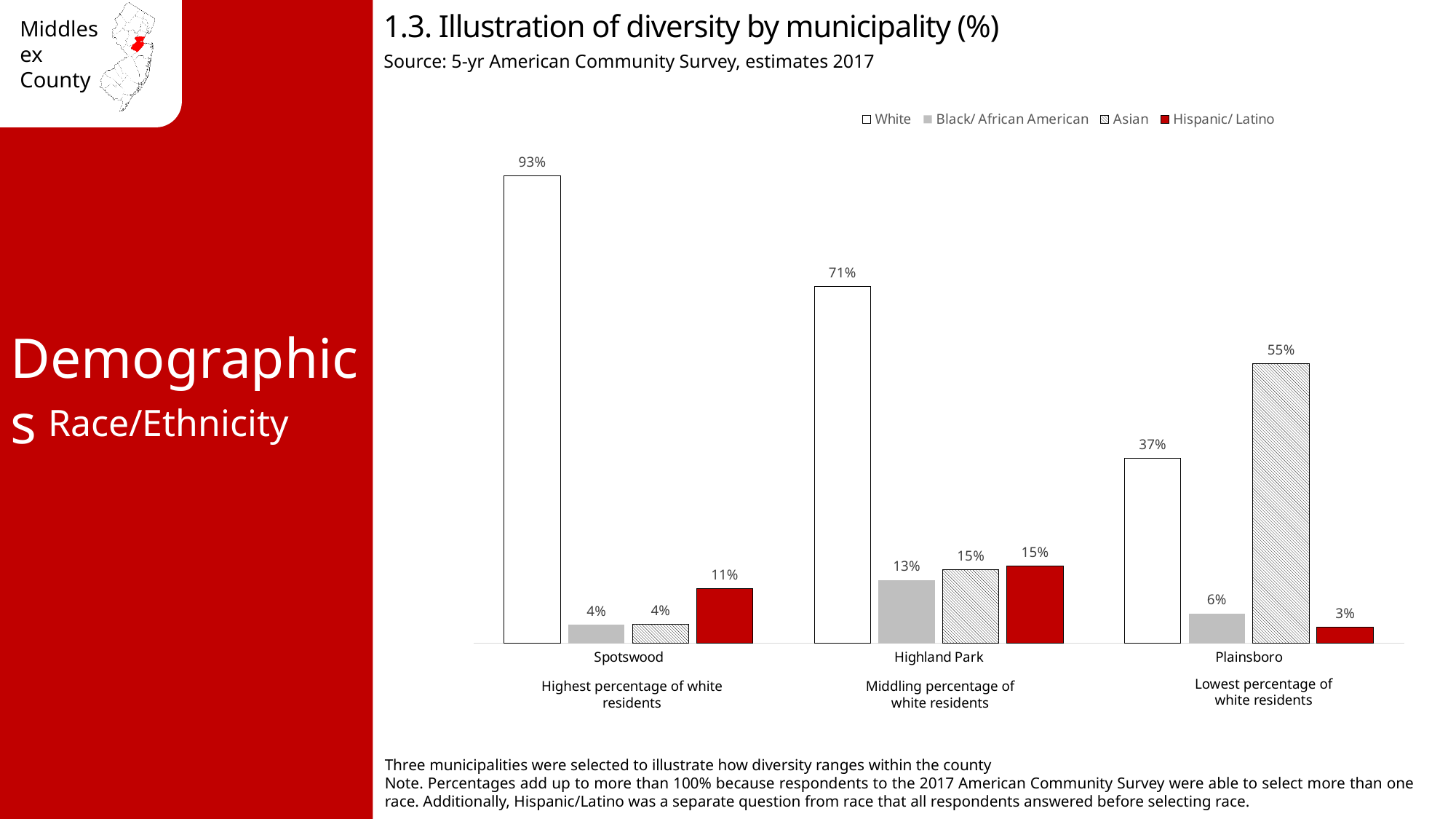
How many municipalities are shown on the chart? 3 What kind of chart is shown on the slide? Bar chart What is the Asian percentage for Plainsboro? 55% Which municipality has the highest White percentage? Spotswood What is the White percentage for Spotswood? 93% What is the Hispanic/ Latino percentage for Highland Park? 15% What is the Black/ African American percentage for Plainsboro? 6% How many series does the legend list? 4 What is the difference between the White percentage in Spotswood and in Highland Park? 22% What is the source cited for the chart? 5-yr American Community Survey, estimates 2017 Which municipality has the lowest Hispanic/ Latino percentage? Plainsboro Which is larger in Plainsboro, the White percentage or the Asian percentage? Asian